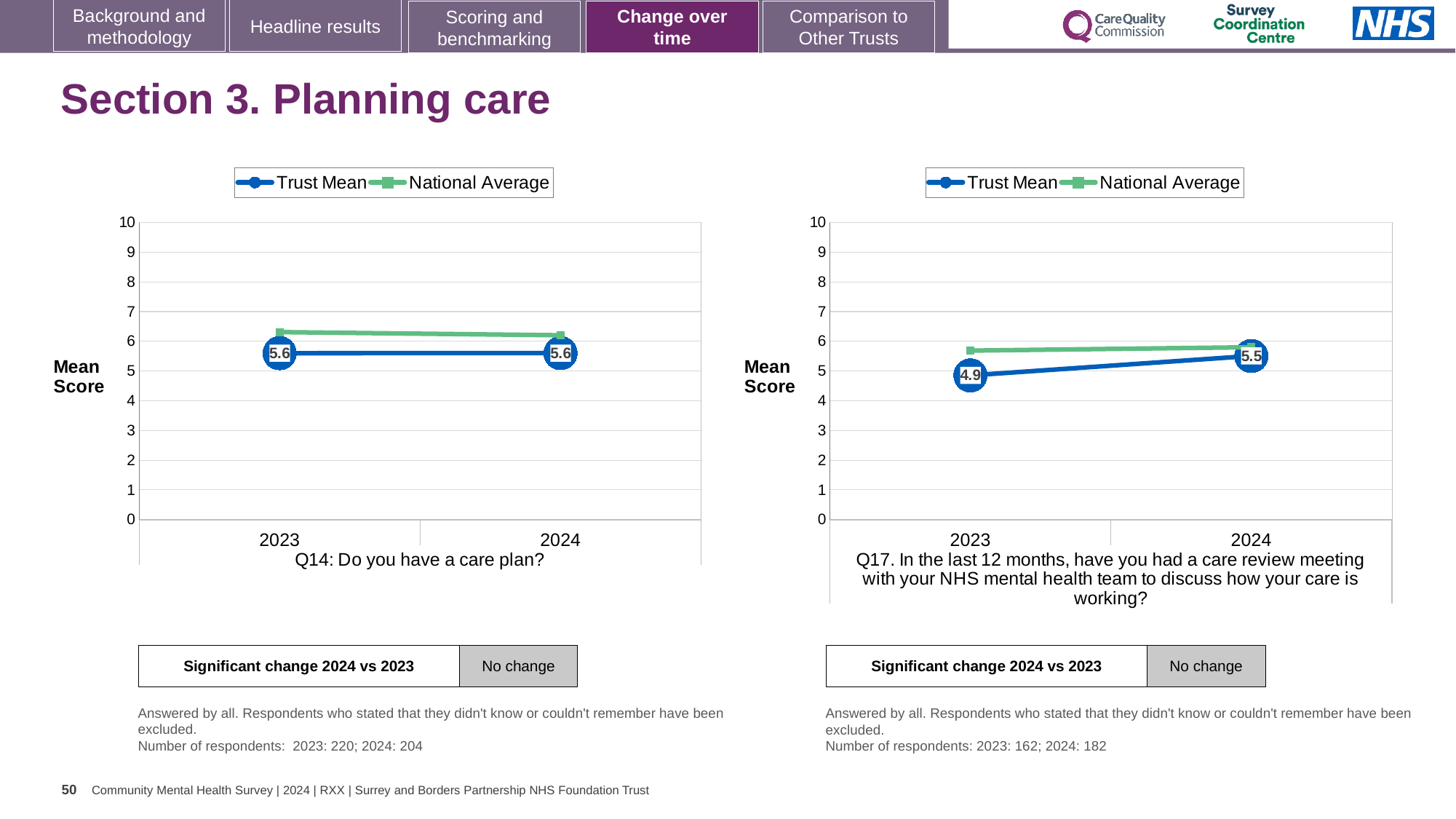
What kind of chart is the Q14 chart (left)? line chart How many years are plotted on the x axis of the Q17 chart (right)? 2 In the Q17 chart (right), is the National Average for 2023 greater or less than 5? greater In the Q14 chart (left), what is the Trust Mean for 2024? 5.6 In the Q14 chart (left), is the National Average for 2023 greater or less than 6? greater In the Q17 chart (right), which is larger in 2023: the Trust Mean or the National Average? National Average In the Q17 chart (right), by how much did the Trust Mean change from 2023 to 2024? 0.6 How many series does the legend of the Q14 chart (left) list? 2 In the Q14 chart (left), what is the Trust Mean for 2023? 5.6 In the Q17 chart (right), does the Trust Mean rise or fall from 2023 to 2024? rise In the Q17 chart (right), what is the Trust Mean for 2024? 5.5 In the Q17 chart (right), what is the Trust Mean for 2023? 4.9